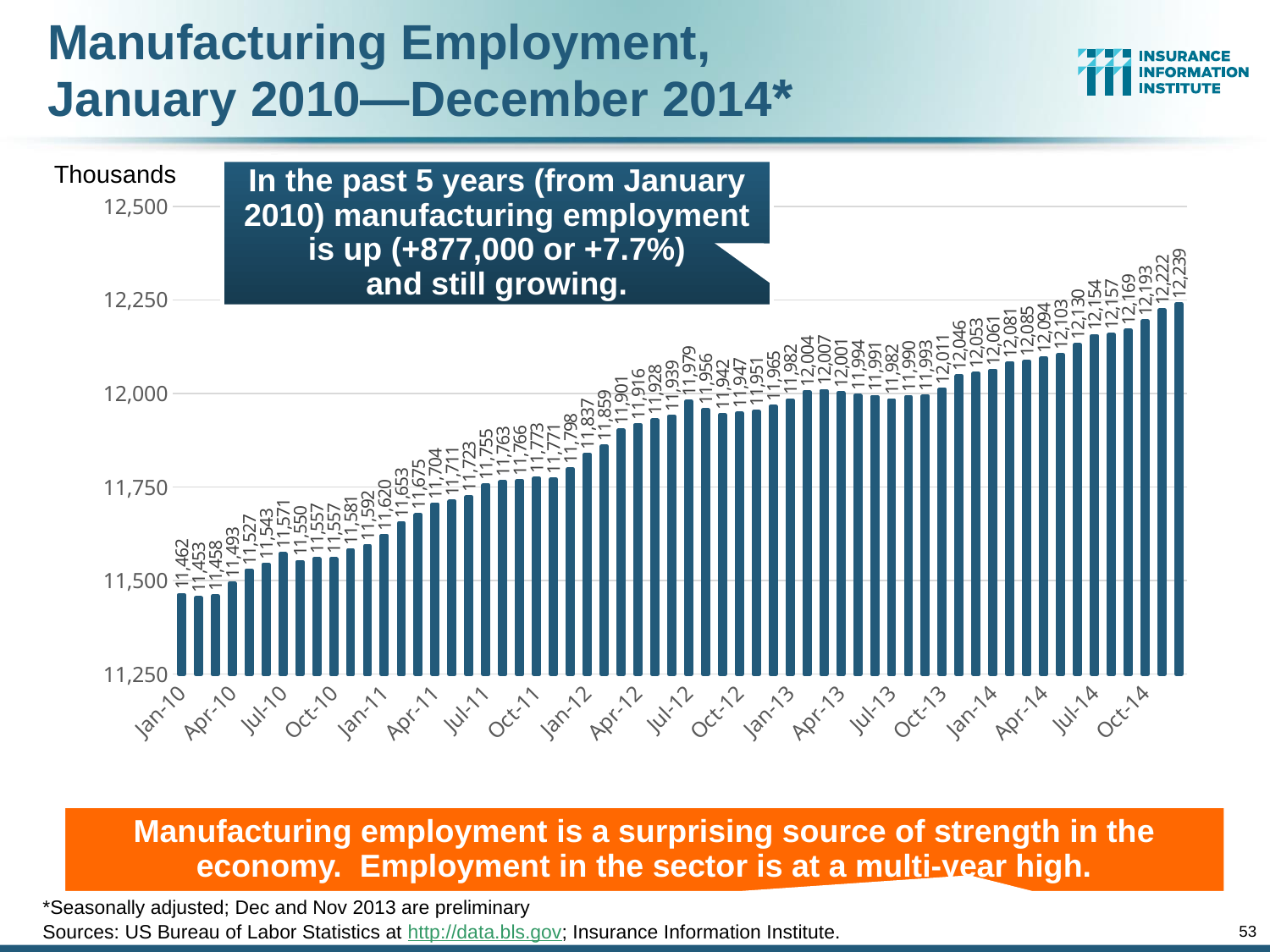
What is the manufacturing employment value for Jan-14? 12,061 Is the value for Jan-12 greater or less than 12,000? less What is the manufacturing employment value for Jan-10? 11,462 What is the lowest value shown on the chart? 11,453 What is the difference between the values for Jan-14 and Jan-13? 79 What is the manufacturing employment value for Oct-14? 12,193 Do the values generally rise or fall from Jan-10 to Dec-14? Rise What is the difference between the values for Oct-14 and Oct-13? 182 Which is larger, the value for Jul-12 or the value for Oct-12? Jul-12 What is the highest value shown on the chart? 12,239 What unit is indicated for the vertical axis of the chart? Thousands What type of chart is shown on the slide? Bar chart